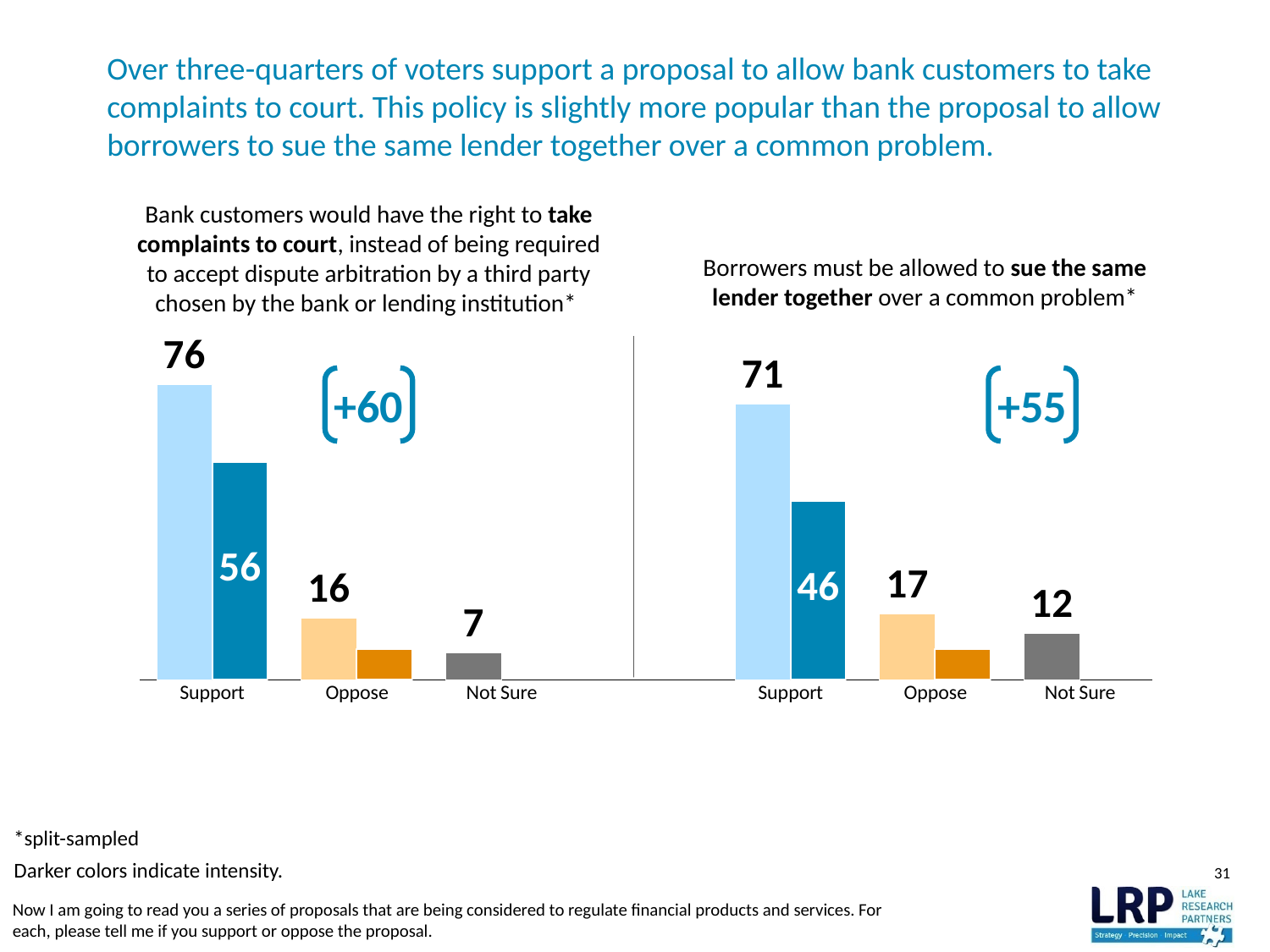
What net figure is shown in brackets on the left chart (take complaints to court)? +60 In the left chart (take complaints to court), what is the difference between the Support and Oppose values? 60 In the left chart (take complaints to court), what is the value of the darker Support bar indicating intensity? 56 In the left chart (take complaints to court), what is the value for Support? 76 In the right chart (sue the same lender together), what is the value for Oppose? 17 In the left chart (take complaints to court), which category has the lowest value? Not Sure How many categories are shown on the x axis of the right chart (sue the same lender together)? 3 In the right chart (sue the same lender together), what is the value for Not Sure? 12 In the right chart (sue the same lender together), what is the difference between the Support and Oppose values? 54 What type of chart is used on the left side of the slide? Bar chart In the right chart (sue the same lender together), which category has the highest value? Support Which is larger: the Support value in the left chart or the Support value in the right chart? Left chart (76)